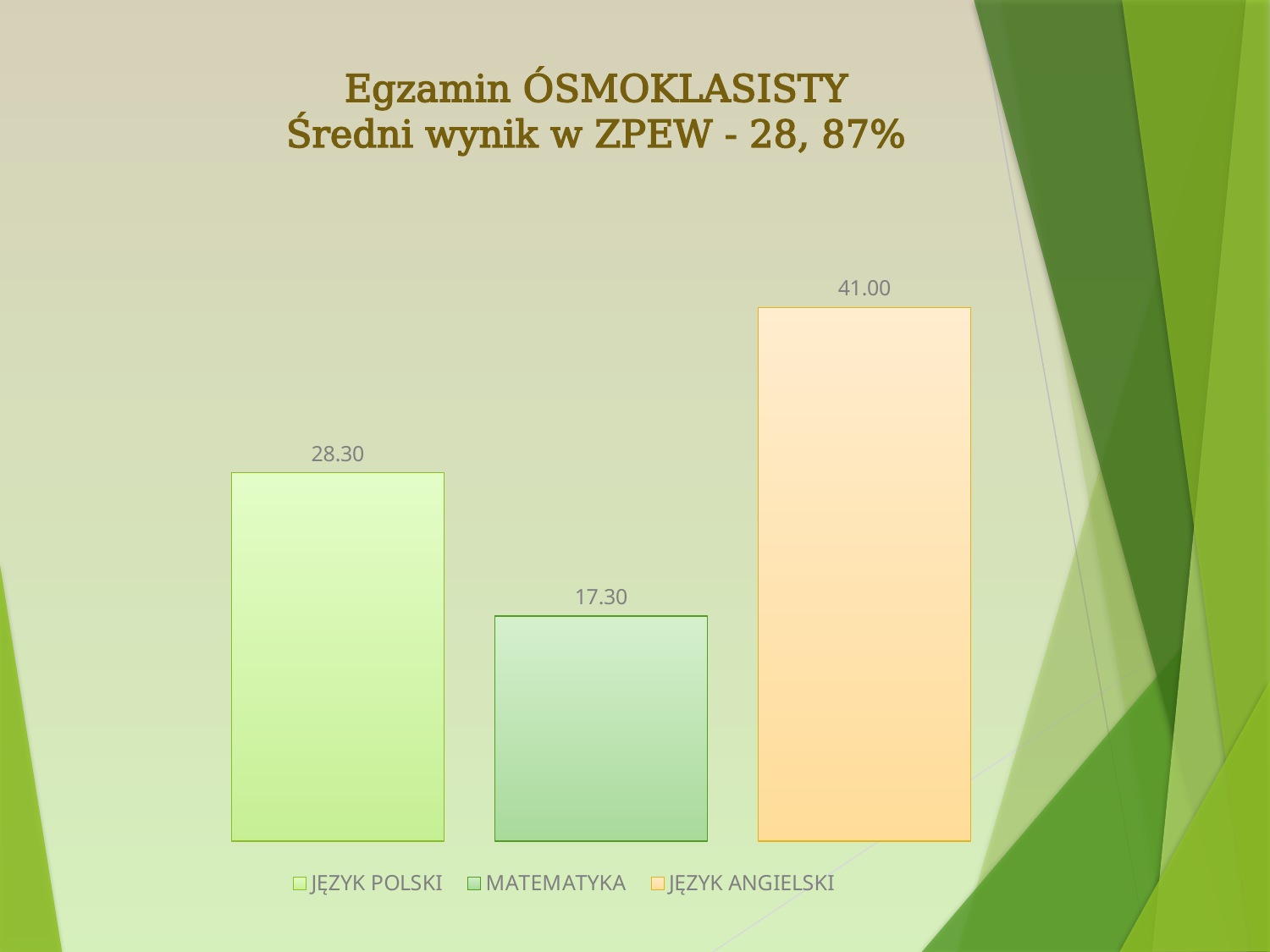
What is the average result in ZPEW stated in the slide title? 28, 87% How many bars are shown in the chart? 3 What is the value for JĘZYK POLSKI? 28.30 What is the difference between the values for JĘZYK POLSKI and MATEMATYKA? 11.00 What kind of chart is shown on the slide? bar chart Which is larger, the value for JĘZYK POLSKI or the value for MATEMATYKA? JĘZYK POLSKI How many entries does the legend list? 3 What is the value for JĘZYK ANGIELSKI? 41.00 What is the difference between the values for JĘZYK ANGIELSKI and JĘZYK POLSKI? 12.70 Which subject has the highest value? JĘZYK ANGIELSKI What is the value for MATEMATYKA? 17.30 Which subject has the lowest value? MATEMATYKA